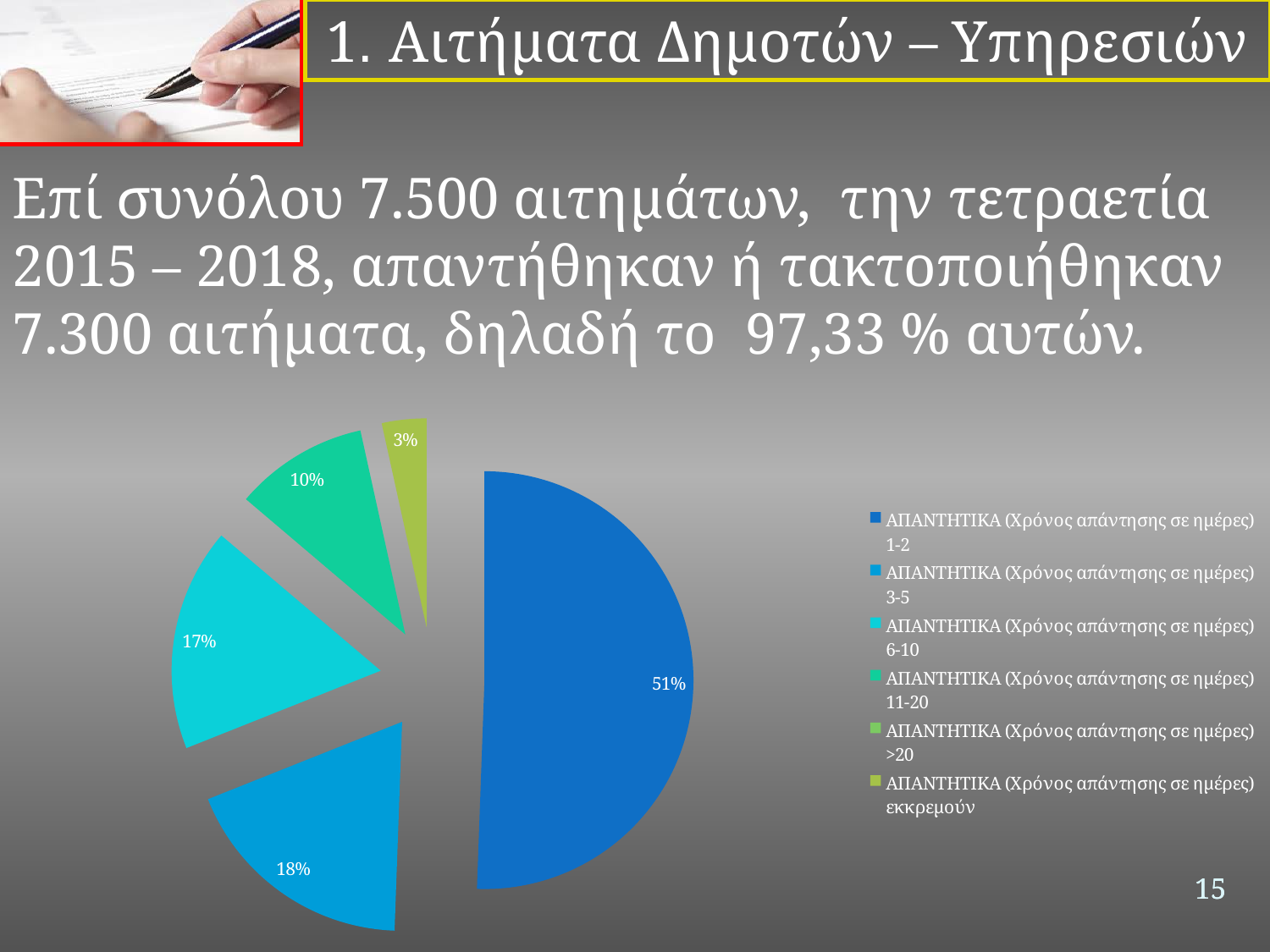
What share of the pie is labelled for the 3-5 days response time category? 18% Which category has the largest slice of the pie chart? ΑΠΑΝΤΗΤΙΚΑ (Χρόνος απάντησης σε ημέρες) 1-2 What percentage is shown for the largest slice of the pie chart? 51% Which slice is larger: the 6-10 days slice or the 11-20 days slice? 6-10 days What is the difference in percentage points between the 1-2 days slice and the 3-5 days slice? 33 What is the title of the slide containing the pie chart? 1. Αιτήματα Δημοτών – Υπηρεσιών What percentage is shown for the 6-10 days response time slice? 17% What is the smallest percentage label printed on the pie chart? 3% How many entries does the legend of the pie chart list? 6 What is the difference in percentage points between the 3-5 days slice and the 11-20 days slice? 8 What percentage is shown for the 11-20 days response time slice? 10% What kind of chart is shown on the slide? pie chart